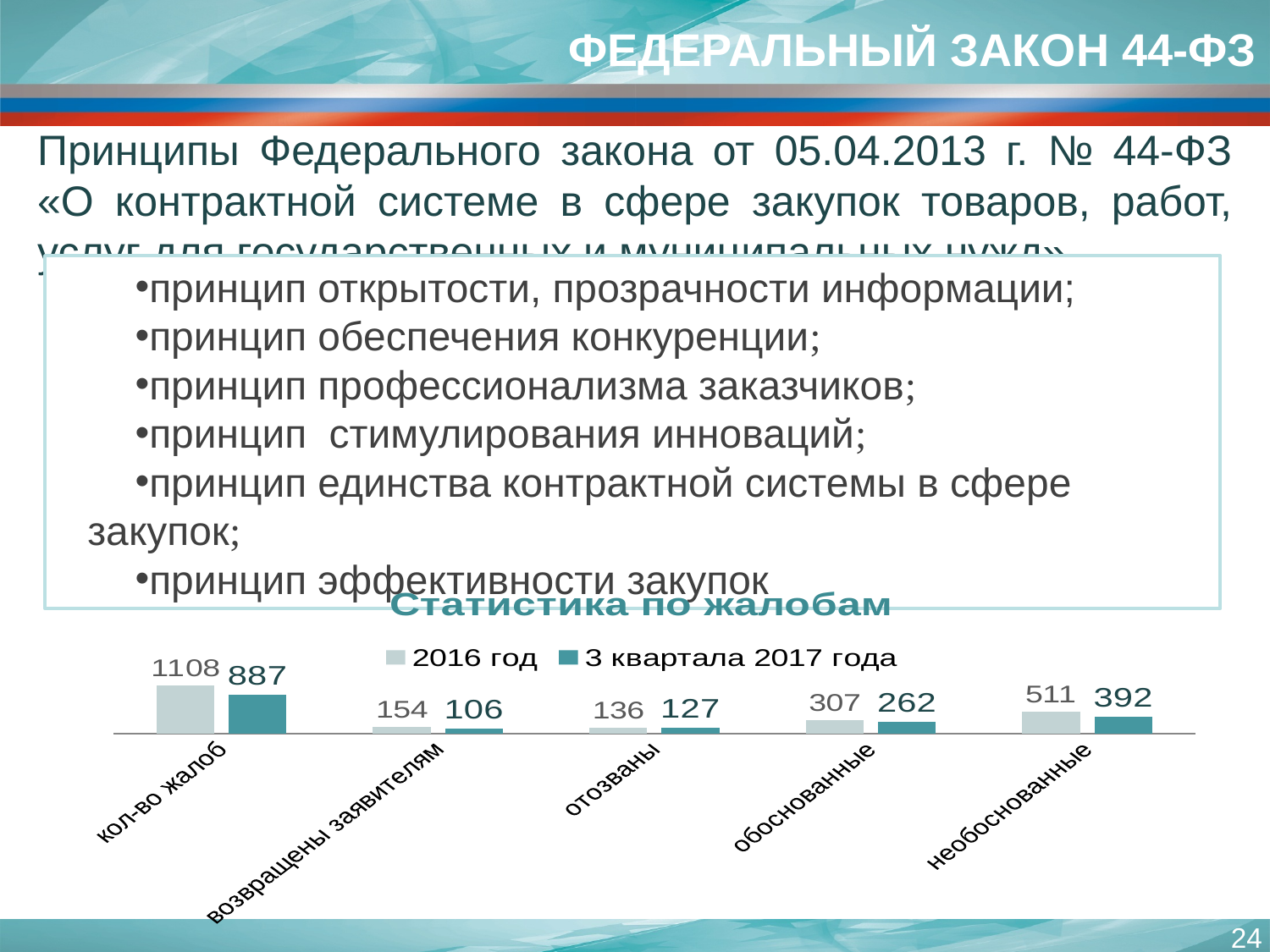
Which category has the highest value in the "2016 год" series? кол-во жалоб What is the title of the chart? Статистика по жалобам What is the difference between the "2016 год" and "3 квартала 2017 года" values for "необоснованные"? 119 How many series does the chart legend list? 2 Which is larger for "возвращены заявителям": the "2016 год" value or the "3 квартала 2017 года" value? 2016 год What is the value for "обоснованные" in the "3 квартала 2017 года" series? 262 What is the value for "отозваны" in the "2016 год" series? 136 What is the value for "необоснованные" in the "3 квартала 2017 года" series? 392 What is the difference between the "2016 год" and "3 квартала 2017 года" values for "кол-во жалоб"? 221 How many categories are shown on the x axis of the chart? 5 What is the value for "кол-во жалоб" in the "2016 год" series? 1108 Which category has the lowest value in the "3 квартала 2017 года" series? возвращены заявителям